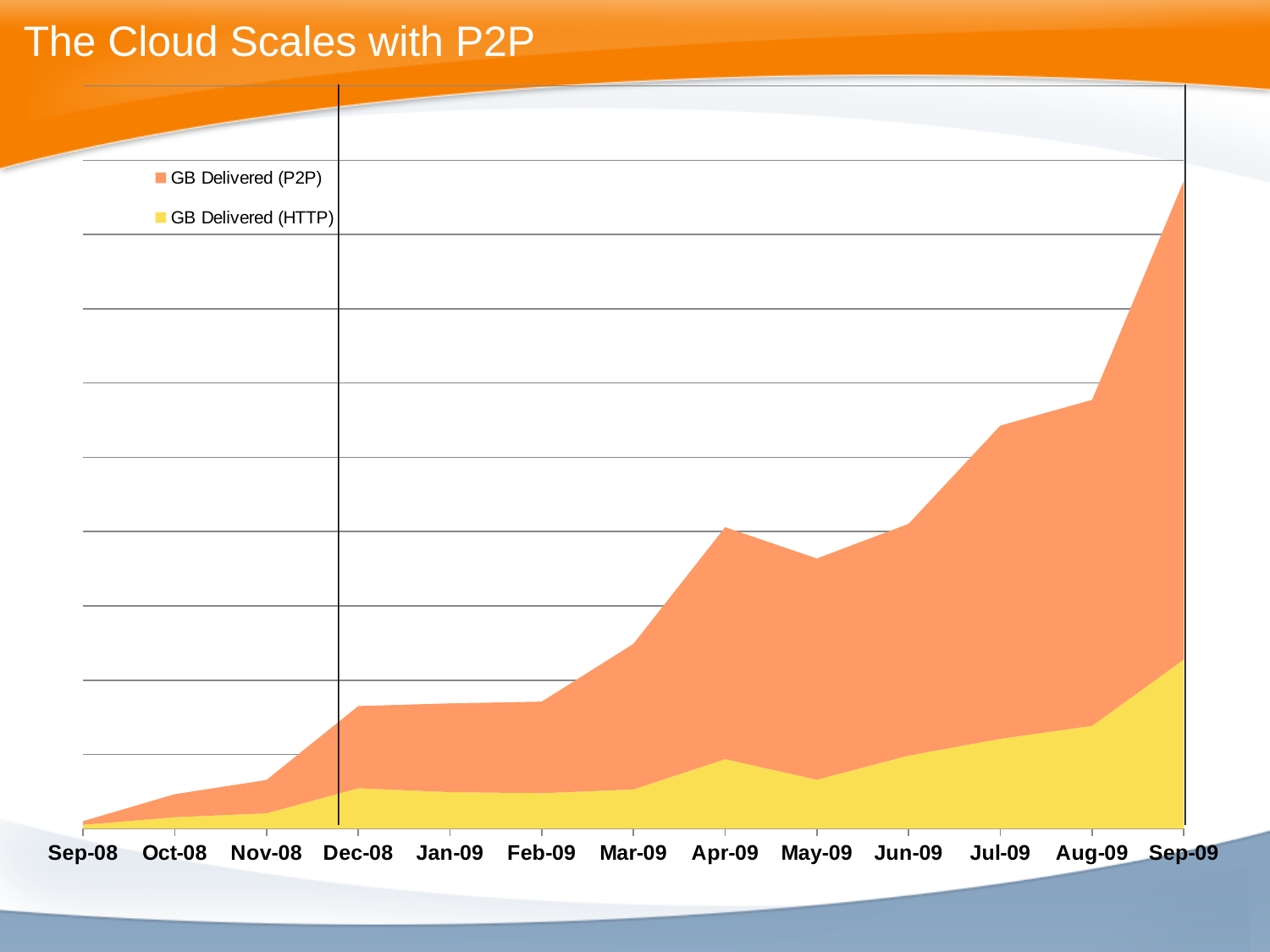
Do the total GB delivered values generally rise or fall from Sep-08 to Sep-09? Rise How many months are shown along the x axis? 13 Which month has a higher total GB delivered, Jul-09 or Jun-09? Jul-09 Which month has the highest total GB delivered? Sep-09 Which month has the lowest total GB delivered? Sep-08 How many series does the legend list? 2 Which colour represents GB Delivered (HTTP) in the chart? Yellow What is the title of the slide containing the chart? The Cloud Scales with P2P Which series is larger in Sep-09, GB Delivered (P2P) or GB Delivered (HTTP)? GB Delivered (P2P) What is the first month shown on the x axis? Sep-08 What kind of chart is shown on the slide? Area chart Which month has a higher total GB delivered, Apr-09 or May-09? Apr-09